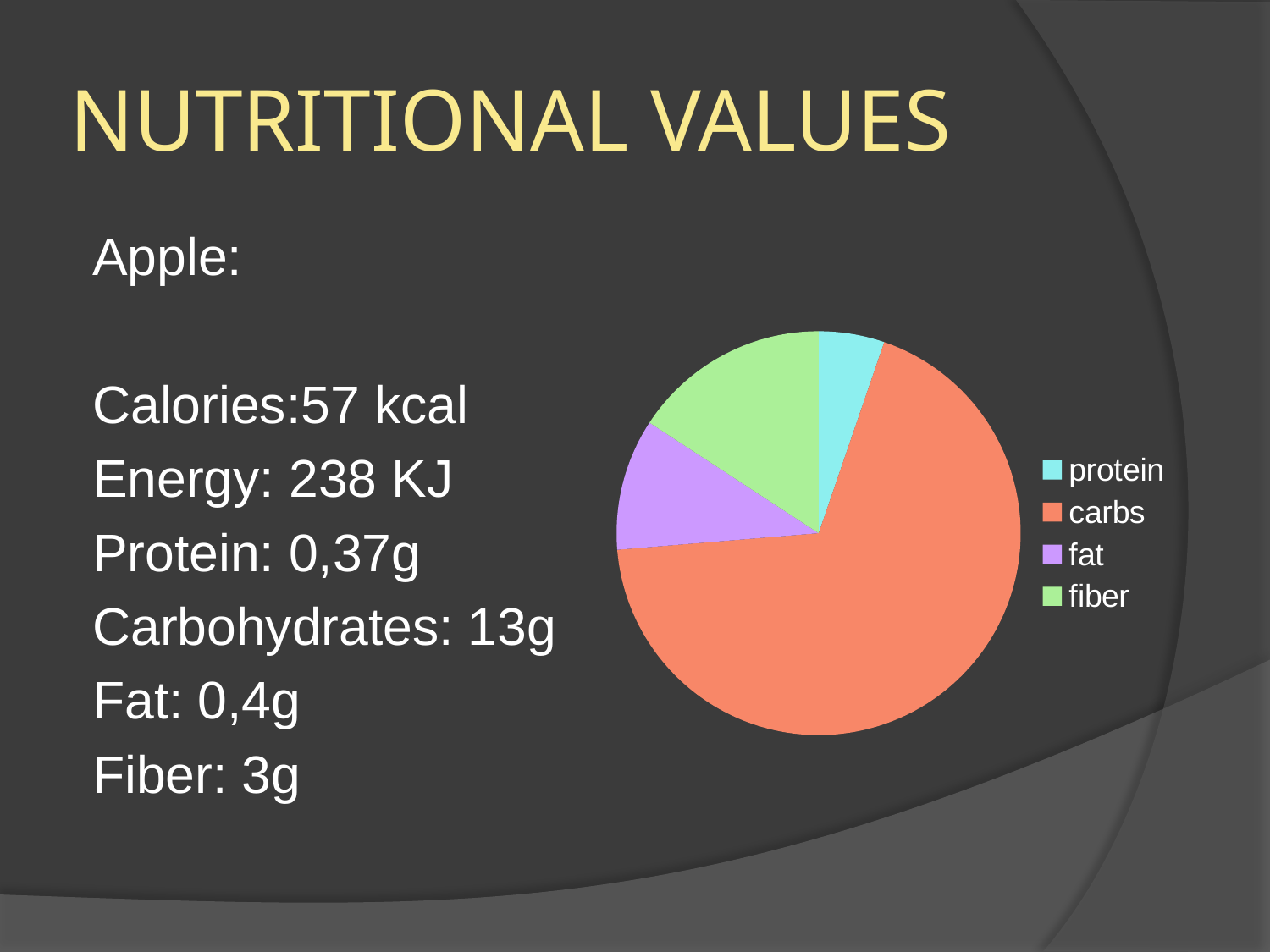
Which slice is larger in the pie chart, carbs or fiber? carbs Which category is shown in green in the pie chart? fiber What colour represents carbs in the pie chart? orange Which slice is larger in the pie chart, fat or protein? fat Which category has the smallest slice in the pie chart? protein How many entries does the legend of the pie chart list? 4 Which category has the largest slice in the pie chart? carbs Which slice is larger in the pie chart, fiber or fat? fiber What kind of chart is shown on the slide? pie chart Does the carbs slice take up more or less than half of the pie chart? more How many slices does the pie chart have? 4